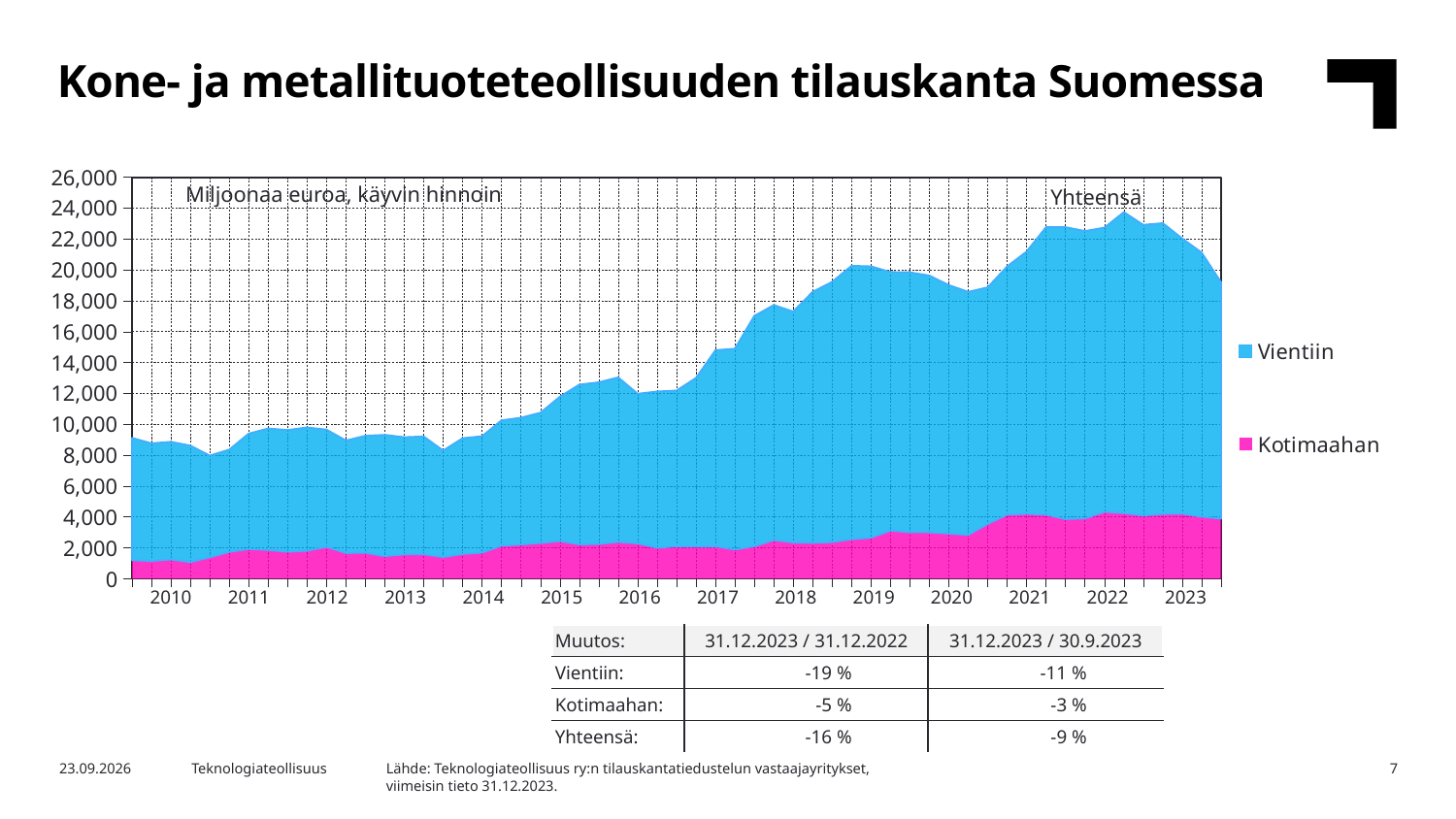
Is the total (Yhteensä) value at the start of 2010 greater or less than 8,000? greater Is the total (Yhteensä) value at the end of 2023 greater or less than 20,000? less Is the Kotimaahan value in 2010 greater or less than 2,000? less Does the total (Yhteensä) rise or fall during 2023? fall How many series does the chart legend list? 2 In which year does the total (Yhteensä) reach its highest level? 2022 What kind of chart is shown on the slide? Area chart What are the two series named in the chart legend? Vientiin and Kotimaahan In 2023, which series is larger, Vientiin or Kotimaahan? Vientiin What unit is stated in the label inside the chart area? Miljoonaa euroa, käyvin hinnoin Does the total (Yhteensä) rise or fall from 2016 to 2019? rise